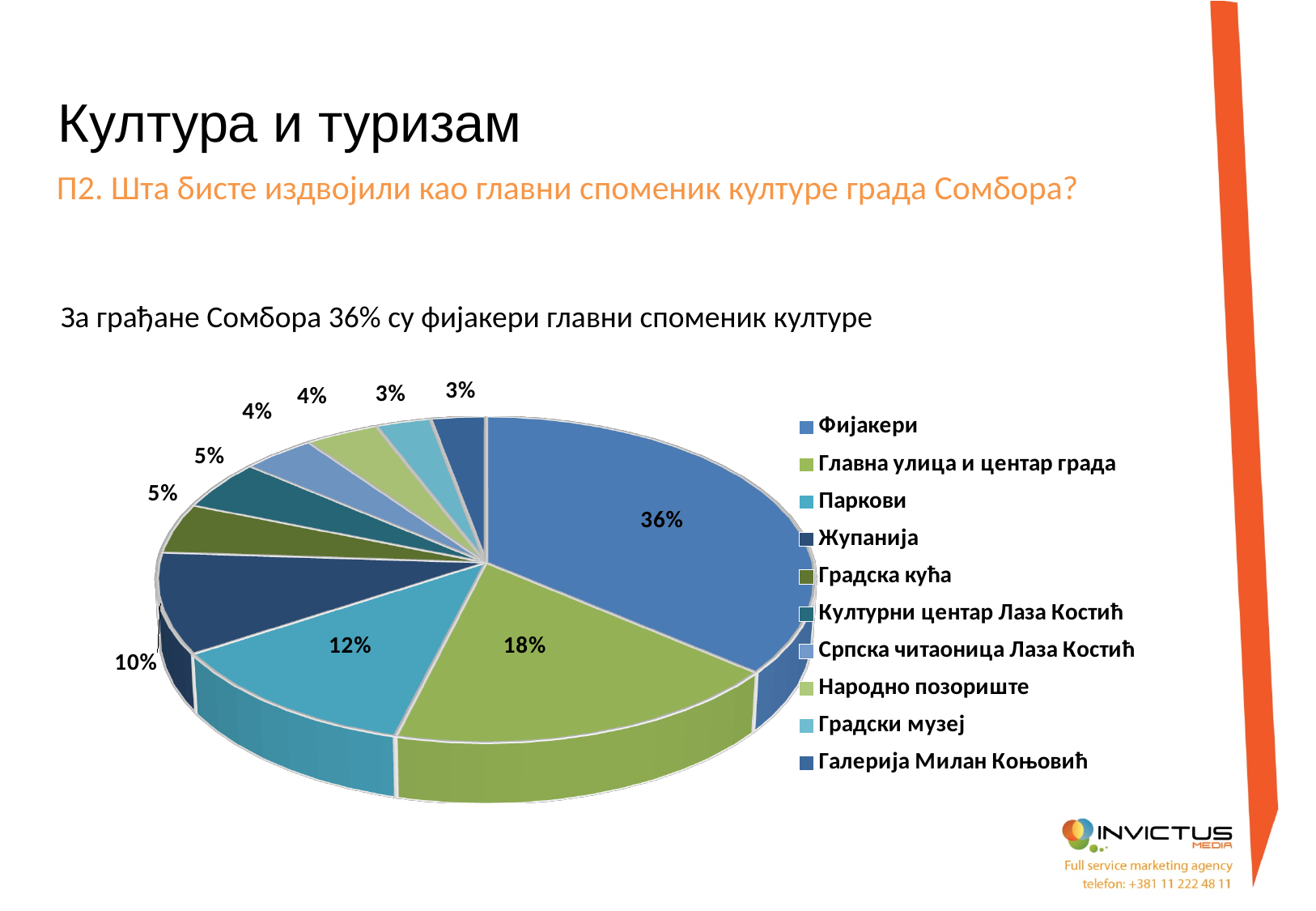
What percentage is shown for Народно позориште? 4% What kind of chart is shown on the slide? Pie chart Which is larger, the share for Паркови or the share for Жупанија? Паркови How many categories are shown in the pie chart? 10 Which category has the largest slice of the pie? Фијакери What percentage is shown for Жупанија? 10% What is the last entry listed in the chart legend? Галерија Милан Коњовић What share of the pie does Фијакери have? 36% What is the value for Градска кућа? 5% What is the difference in percentage points between Фијакери and Главна улица и центар града? 18 What percentage is shown for Главна улица и центар града? 18% What is the value for Паркови? 12%